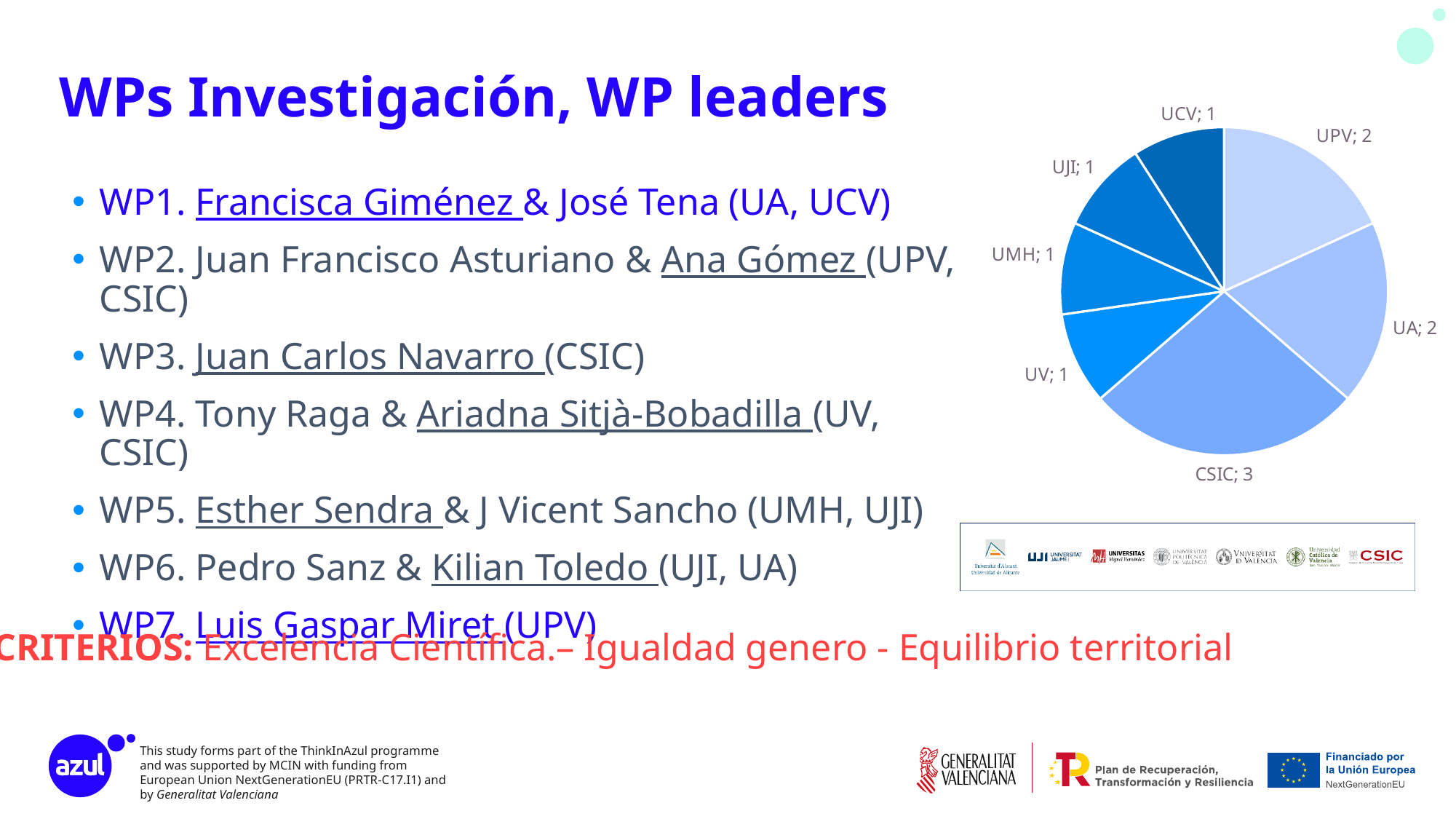
Which is larger in the pie chart, CSIC or UPV? CSIC How many categories are shown in the pie chart? 7 What is the value for CSIC in the pie chart? 3 What is the value for UMH in the pie chart? 1 What is the total of all the values shown in the pie chart? 11 What is the value for UCV in the pie chart? 1 What share of the pie chart's total does CSIC represent? 3/11 Which category has the largest slice in the pie chart? CSIC What type of chart is shown on the slide? pie chart What is the value for UA in the pie chart? 2 What is the value for UPV in the pie chart? 2 What is the difference between the values for CSIC and UV in the pie chart? 2